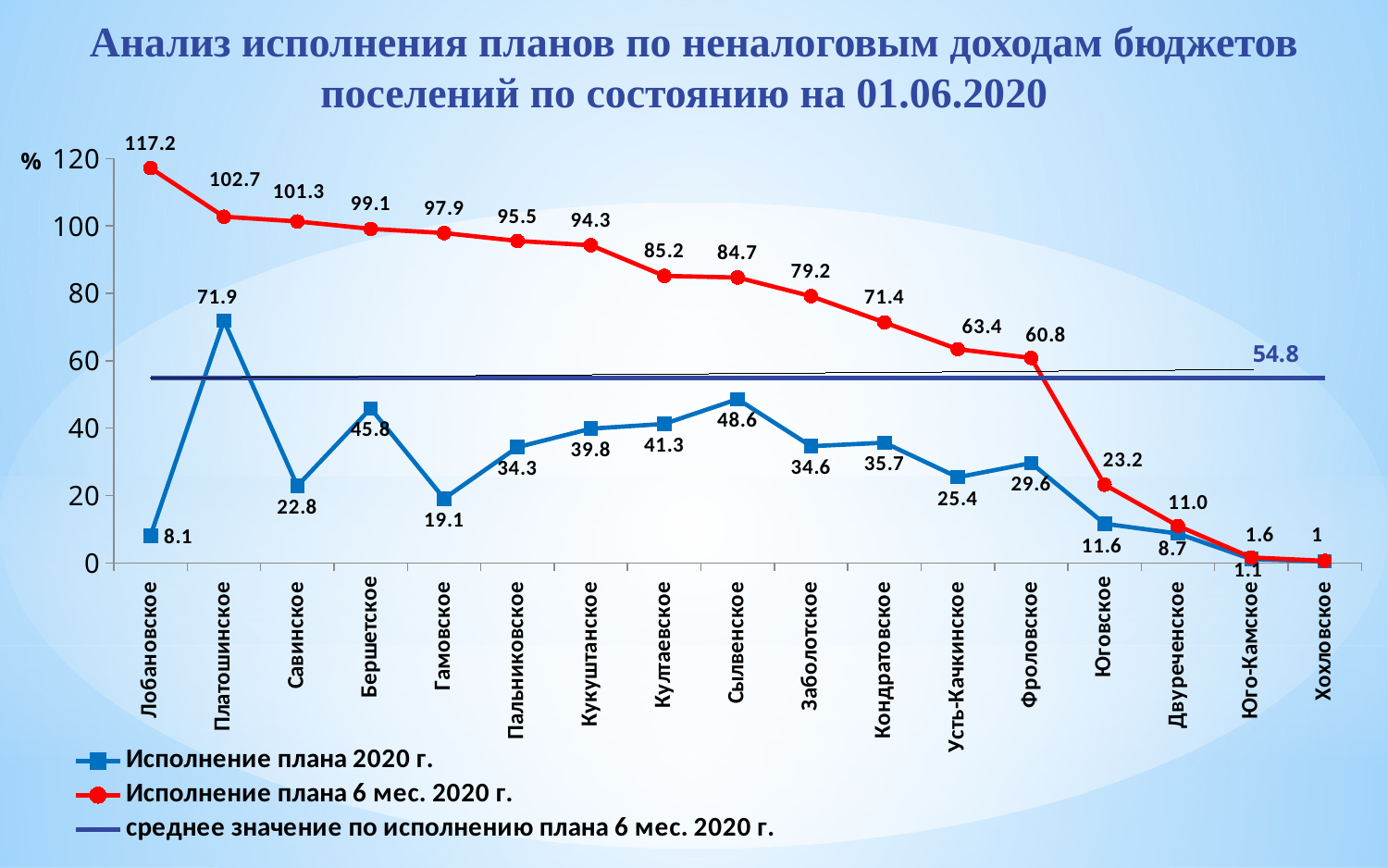
Which is larger in the 'Исполнение плана 2020 г.' series: Бершетское or Сылвенское? Сылвенское Which settlement has the highest value in the 'Исполнение плана 2020 г.' series? Платошинское Which settlement has the lowest value in the 'Исполнение плана 6 мес. 2020 г.' series? Хохловское How many series does the legend list? 3 What is the difference between 'Исполнение плана 6 мес. 2020 г.' and 'Исполнение плана 2020 г.' for Лобановское? 109.1 What is the value of 'Исполнение плана 2020 г.' for Платошинское? 71.9 Does the 'Исполнение плана 6 мес. 2020 г.' series rise or fall from left to right along the x axis? fall What kind of chart is shown on the slide? line chart Is the 'Исполнение плана 6 мес. 2020 г.' value for Кондратовское greater or less than 80? less What is the value shown for the average line 'среднее значение по исполнению плана 6 мес. 2020 г.'? 54.8 What is the value of 'Исполнение плана 6 мес. 2020 г.' for Лобановское? 117.2 How many settlements are shown on the x axis? 17